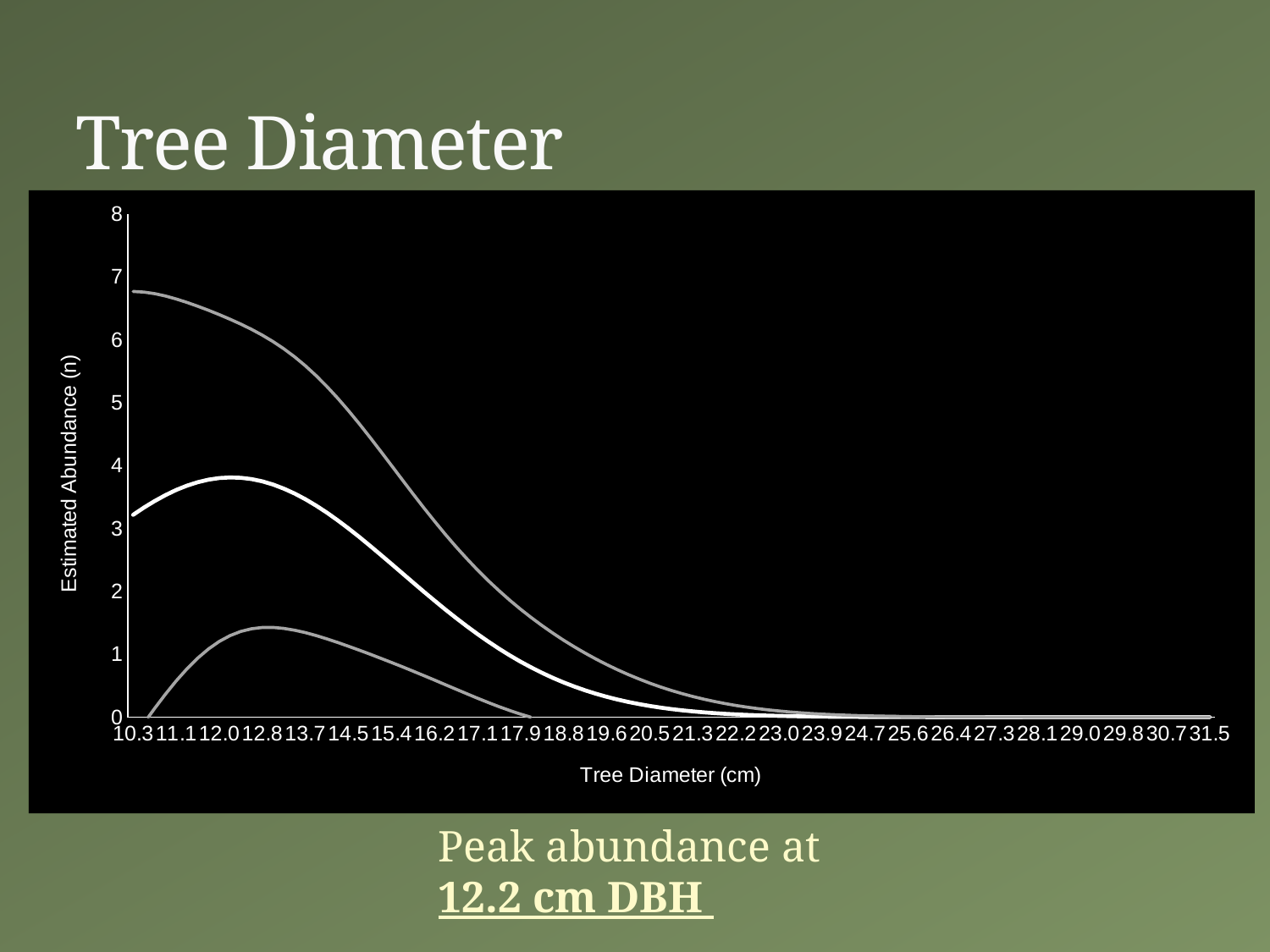
Is the value of the white line at 10.3 cm greater or less than 4? less Is the peak value of the lowest grey line greater or less than 1? greater What is the title of the x axis? Tree Diameter (cm) What is the title of the y axis? Estimated Abundance (n) What is the first tree diameter label on the x axis? 10.3 How many lines are plotted on the chart? 3 Is the value of the top grey line at 10.3 cm greater or less than 6? greater What is the highest value shown on the y axis? 8 What is the last tree diameter label on the x axis? 31.5 What kind of chart is shown on the slide? Line chart Does the top grey line rise or fall as tree diameter increases? Fall At 10.3 cm, which is larger: the top grey line or the white line? The top grey line